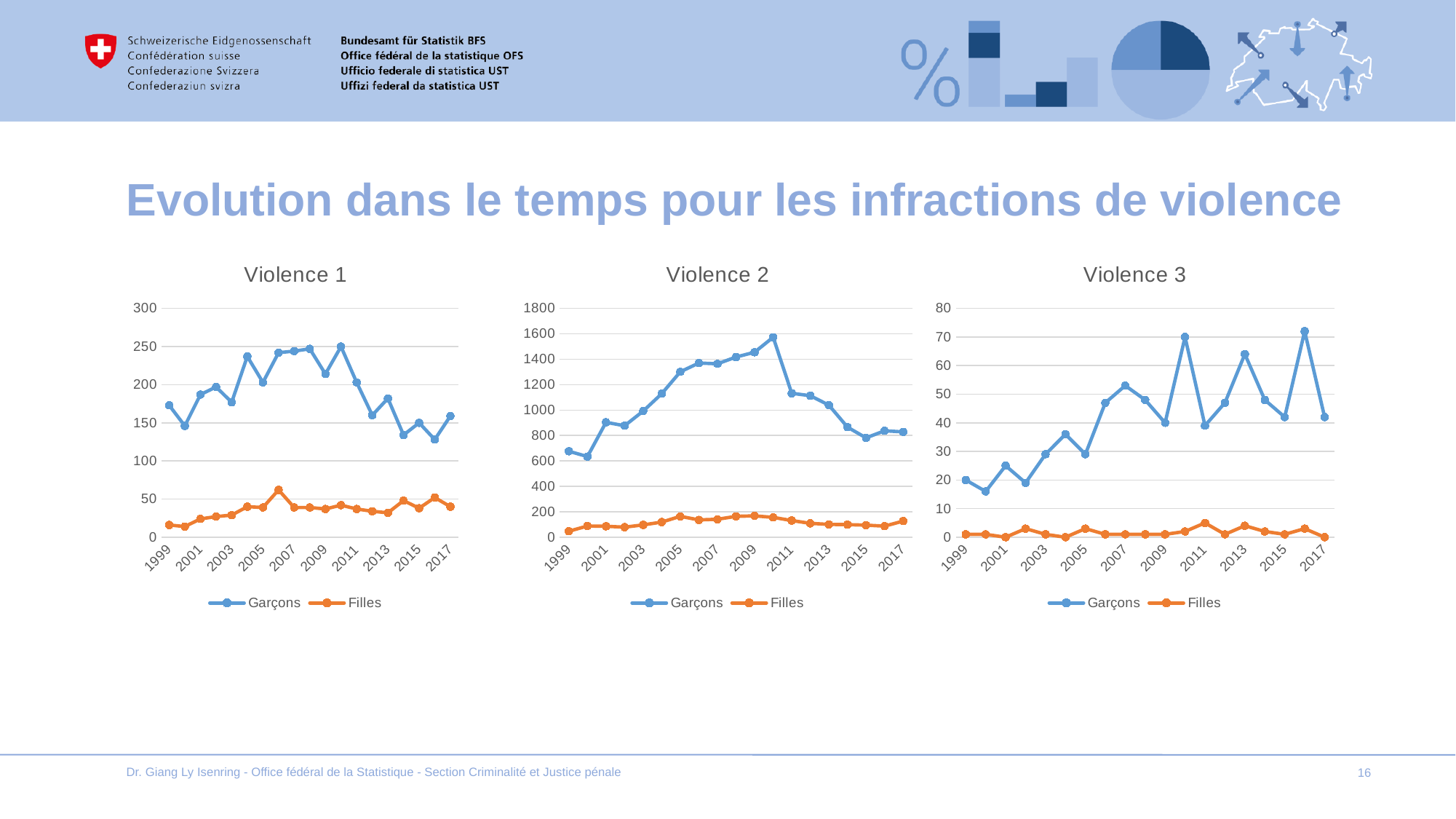
In the Violence 2 chart, does the Garçons series rise or fall between 1999 and 2010? rise In the Violence 2 chart, is the Garçons value for 2010 greater or less than 1400? greater What kind of chart is the Violence 1 chart? line chart How many series does the legend of the Violence 2 chart list? 2 In the Violence 3 chart, is the Garçons value for 2016 greater or less than 60? greater In the Violence 1 chart, is the Garçons value for 2010 greater or less than 200? greater In the Violence 1 chart, which series has the larger value in 2017, Garçons or Filles? Garçons How many years are plotted on the x axis of the Violence 3 chart? 19 What is the title of the chart on the right of the slide? Violence 3 In the Violence 2 chart, in which year does the Garçons series reach its highest value? 2010 In the Violence 1 chart, in which year does the Filles series reach its highest value? 2006